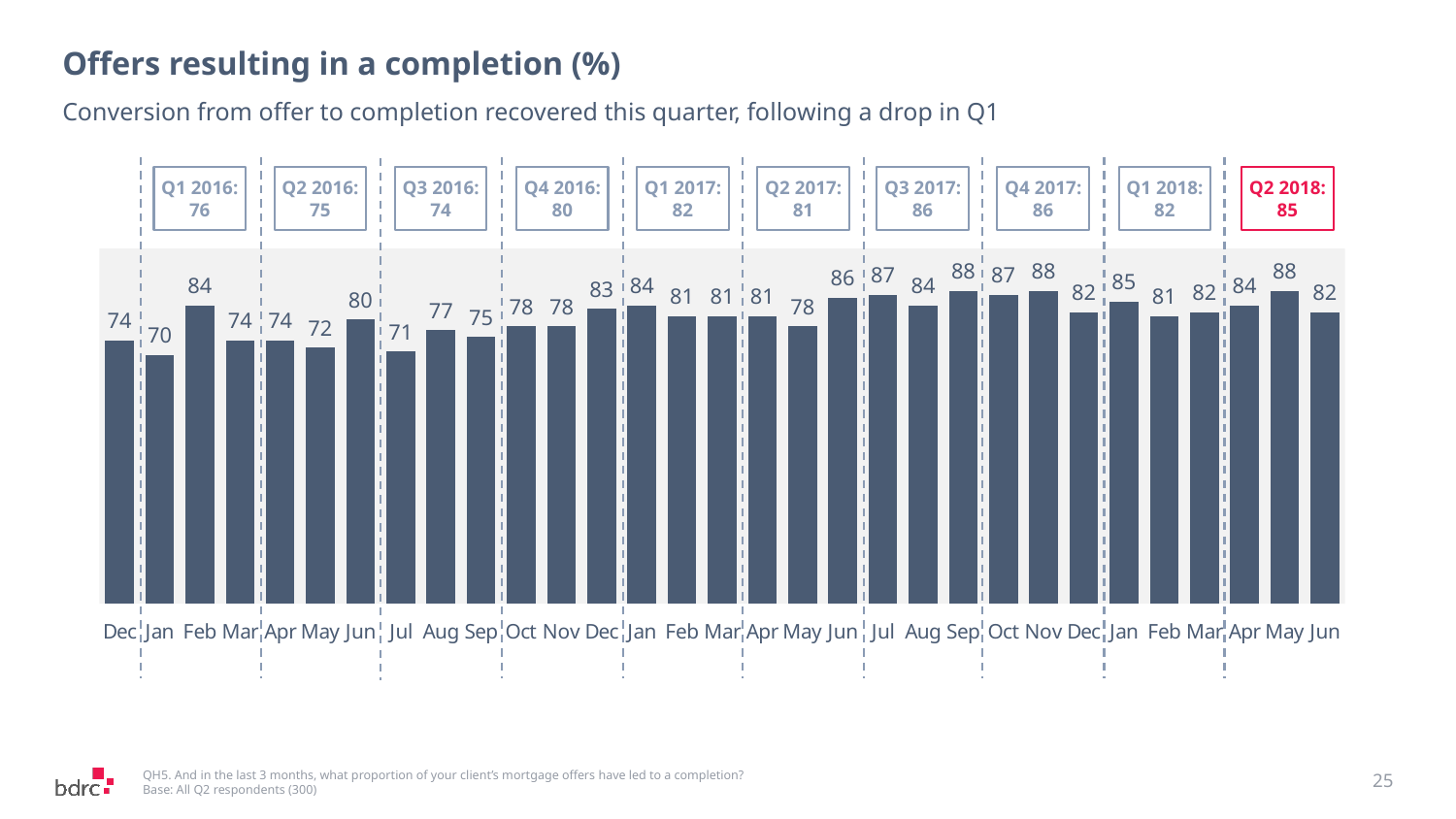
What is the value shown in the Q3 2016 box? 74 What is the value of the May bar within the Q2 2018 section? 88 What type of chart is shown on the slide? Bar chart Which is larger, the Q4 2016 value or the Q3 2016 value? Q4 2016 What is the value of the Jan bar within the Q1 2016 section? 70 Which quarter box shows the lowest value? Q3 2016 How many monthly bars are plotted on the chart? 31 What is the highest monthly value shown on the chart? 88 How many quarter boxes are shown above the chart? 10 What is the value shown in the Q2 2018 box? 85 What is the difference between the Q2 2018 value and the Q1 2018 value? 3 What is the lowest monthly value shown on the chart? 70